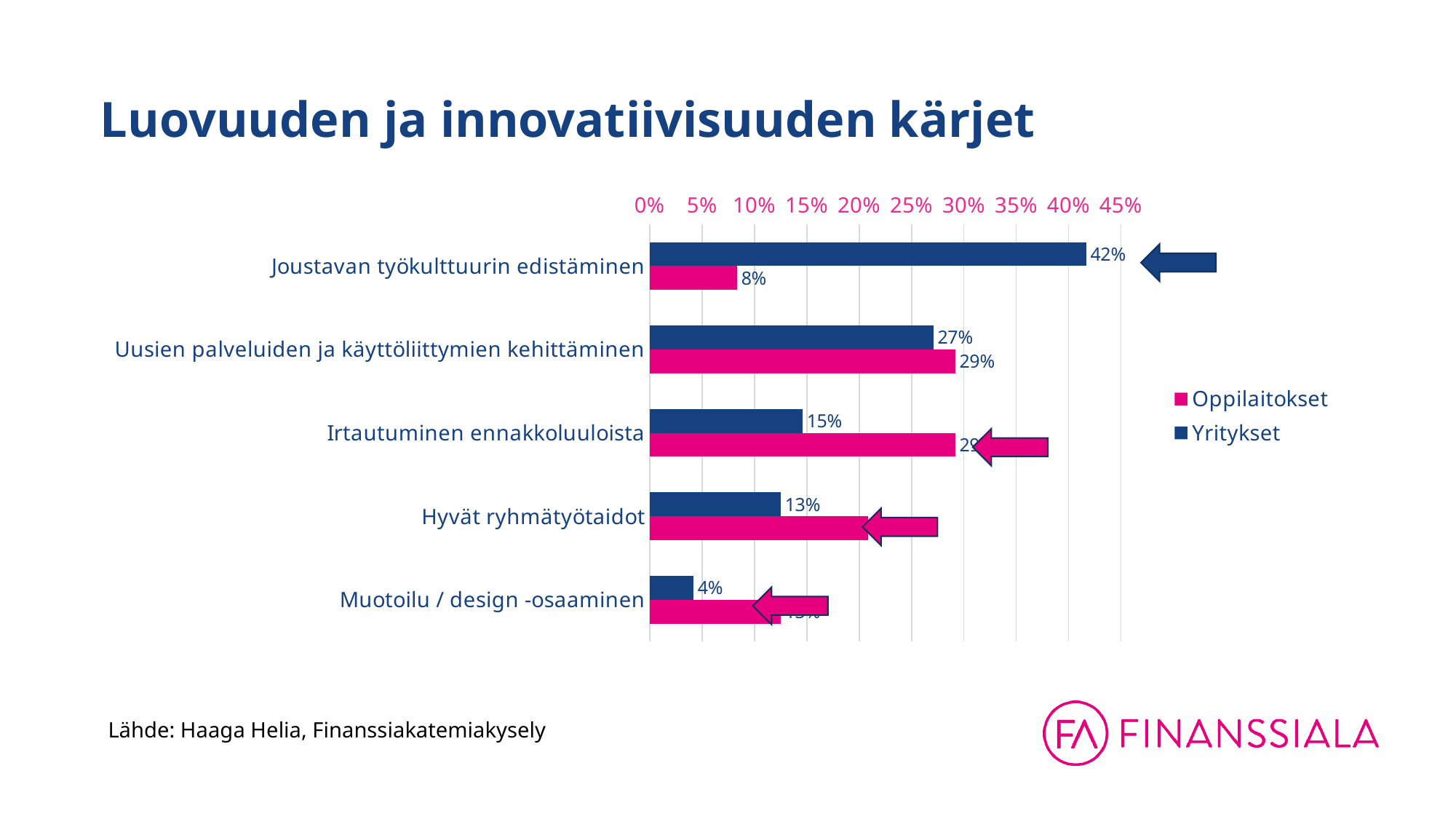
Is the Oppilaitokset value for Hyvät ryhmätyötaidot greater or less than 15%? greater What is the Yritykset value for Muotoilu / design -osaaminen? 4% What is the Oppilaitokset value for Uusien palveluiden ja käyttöliittymien kehittäminen? 29% What type of chart is shown on the slide? Bar chart Which category has the lowest Yritykset value? Muotoilu / design -osaaminen What is the difference between the Yritykset and Oppilaitokset values for Joustavan työkulttuurin edistäminen? 34 percentage points Which category has the highest Yritykset value? Joustavan työkulttuurin edistäminen What is the Oppilaitokset value for Joustavan työkulttuurin edistäminen? 8% What is the Yritykset value for Joustavan työkulttuurin edistäminen? 42% How many categories are shown in the chart? 5 How many series does the legend list? 2 For Irtautuminen ennakkoluuloista, which series has the larger value, Oppilaitokset or Yritykset? Oppilaitokset